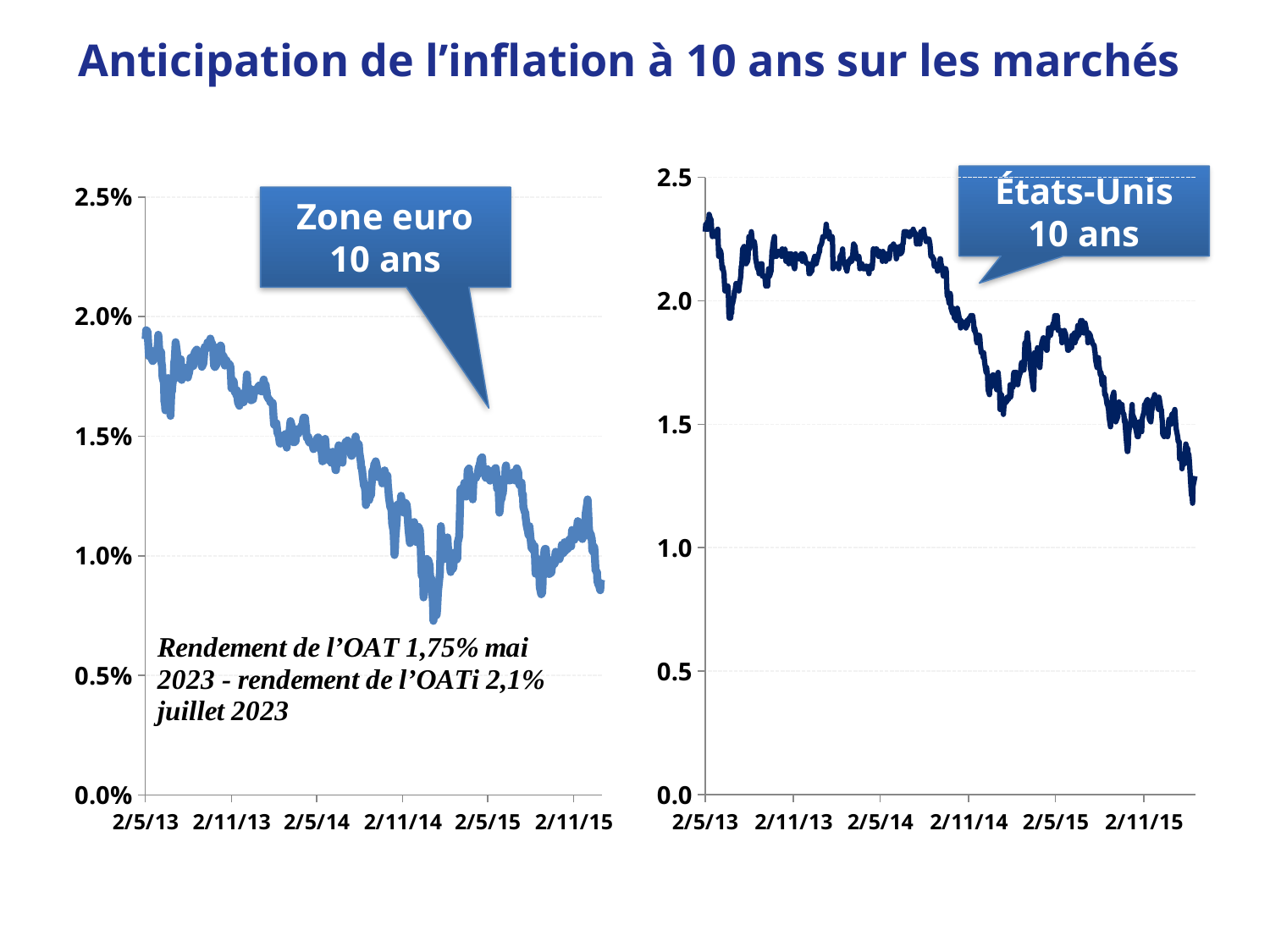
In the right chart (États-Unis 10 ans), do the values overall rise or fall from 2/5/13 to the end of the series? fall What kind of chart is the right chart labelled "États-Unis 10 ans"? line chart What kind of chart is the left chart labelled "Zone euro 10 ans"? line chart In the left chart (Zone euro 10 ans), is the value at 2/5/13 larger or smaller than the value at 2/11/15? larger In the left chart (Zone euro 10 ans), do the values overall rise or fall from 2/5/13 to the end of the series? fall What is the title of the slide? Anticipation de l’inflation à 10 ans sur les marchés In the right chart (États-Unis 10 ans), is the value at 2/5/14 larger or smaller than the value at 2/11/15? larger In the left chart (Zone euro 10 ans), is the value at 2/5/13 greater or less than 1.5%? greater In the right chart (États-Unis 10 ans), is the value at 2/5/13 greater or less than 2.0? greater What is the highest value shown on the y axis of the left chart (Zone euro 10 ans)? 2.5% In the right chart (États-Unis 10 ans), is the value at the end of the series greater or less than 1.5? less